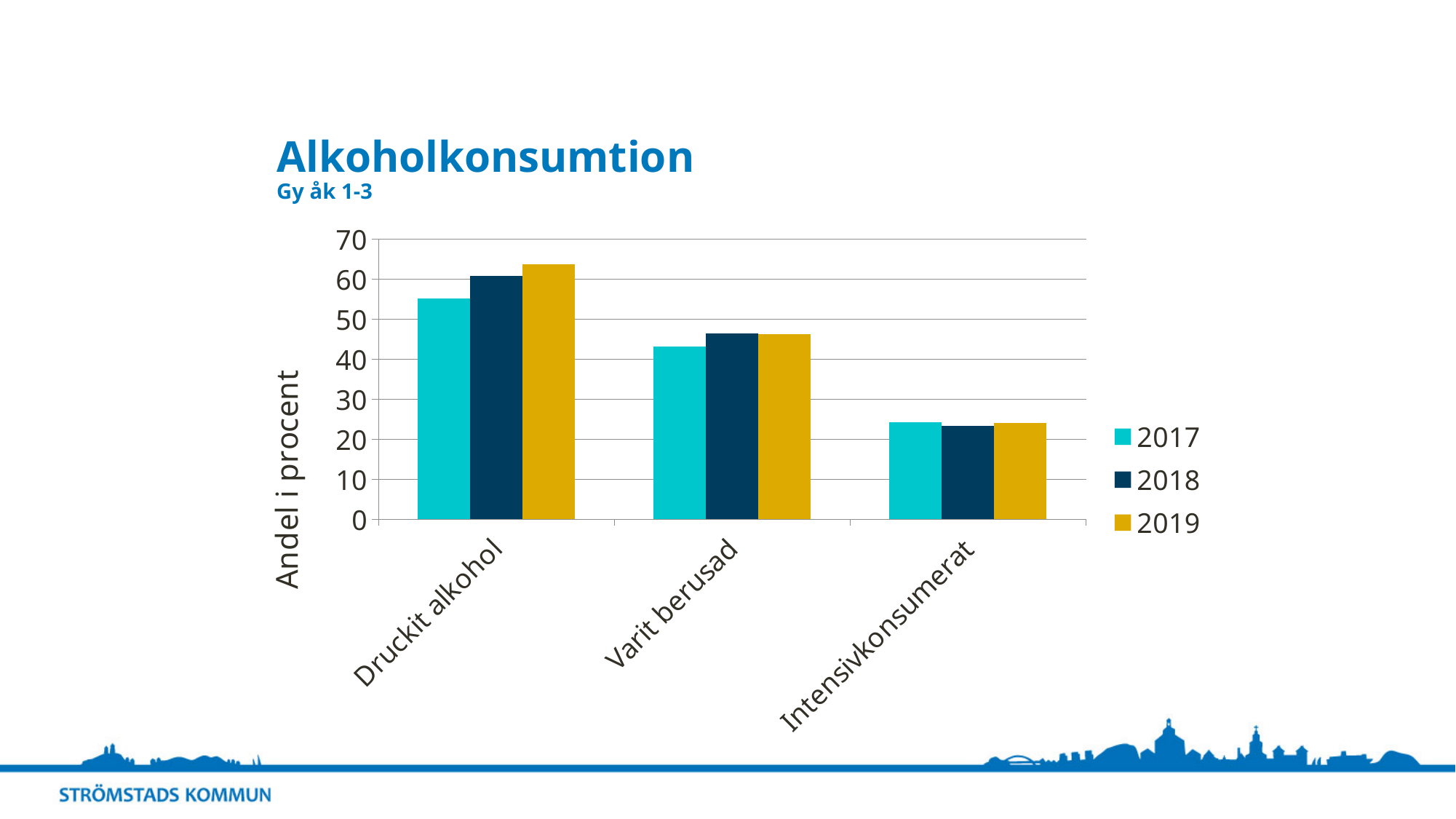
What kind of chart is shown on the slide? bar chart How many categories are shown on the x axis? 3 For Druckit alkohol, do the values rise or fall from 2017 to 2019? rise Which category has the highest values across all years? Druckit alkohol Is the value for Druckit alkohol in 2019 greater or less than 60? greater Is the value for Intensivkonsumerat in 2018 greater or less than 30? less Which category has the lowest values across all years? Intensivkonsumerat What is the label of the y axis? Andel i procent How many series does the legend list? 3 Is the value for Druckit alkohol in 2017 greater or less than 60? less For Druckit alkohol, which year has the larger value, 2017 or 2019? 2019